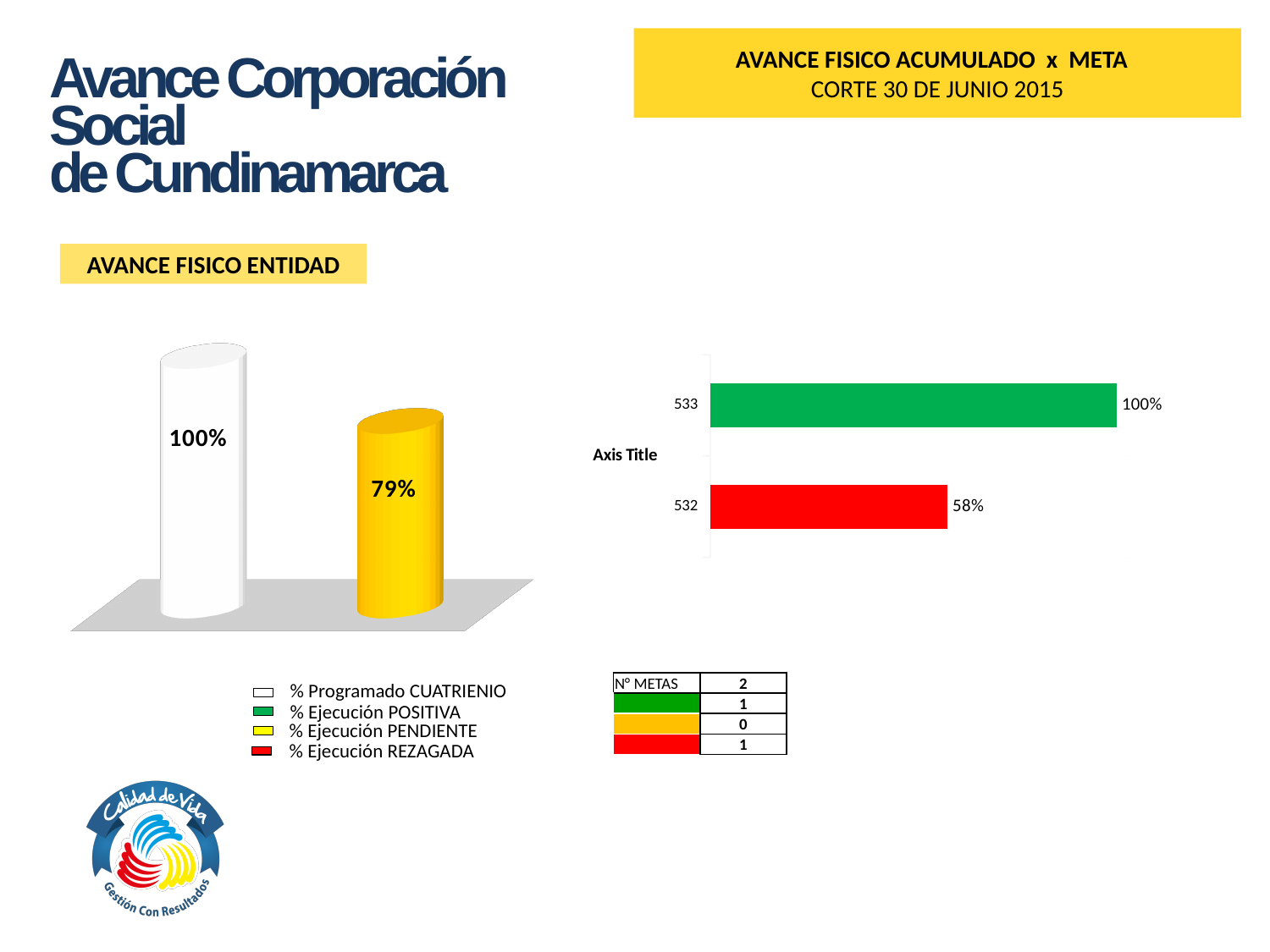
What kind of chart is the AVANCE FISICO ACUMULADO x META chart? Bar chart In the AVANCE FISICO ENTIDAD chart, which bar is larger, the white bar or the yellow bar? The white bar In the AVANCE FISICO ENTIDAD chart, what is the value of the white bar (% Programado CUATRIENIO)? 100% In the AVANCE FISICO ACUMULADO x META chart, what is the difference between the values for meta 533 and meta 532? 42% In the AVANCE FISICO ACUMULADO x META chart, what is the value for meta 533? 100% How many entries does the legend at the bottom of the slide list? 4 In the AVANCE FISICO ENTIDAD chart, what is the difference between the white bar and the yellow bar? 21% In the AVANCE FISICO ENTIDAD chart, what is the value of the yellow bar (% Ejecución PENDIENTE)? 79% In the AVANCE FISICO ACUMULADO x META chart, how many metas are plotted? 2 In the AVANCE FISICO ACUMULADO x META chart, what is the value for meta 532? 58% In the AVANCE FISICO ACUMULADO x META chart, which meta has the highest value? 533 In the AVANCE FISICO ACUMULADO x META chart, which meta has the lowest value? 532